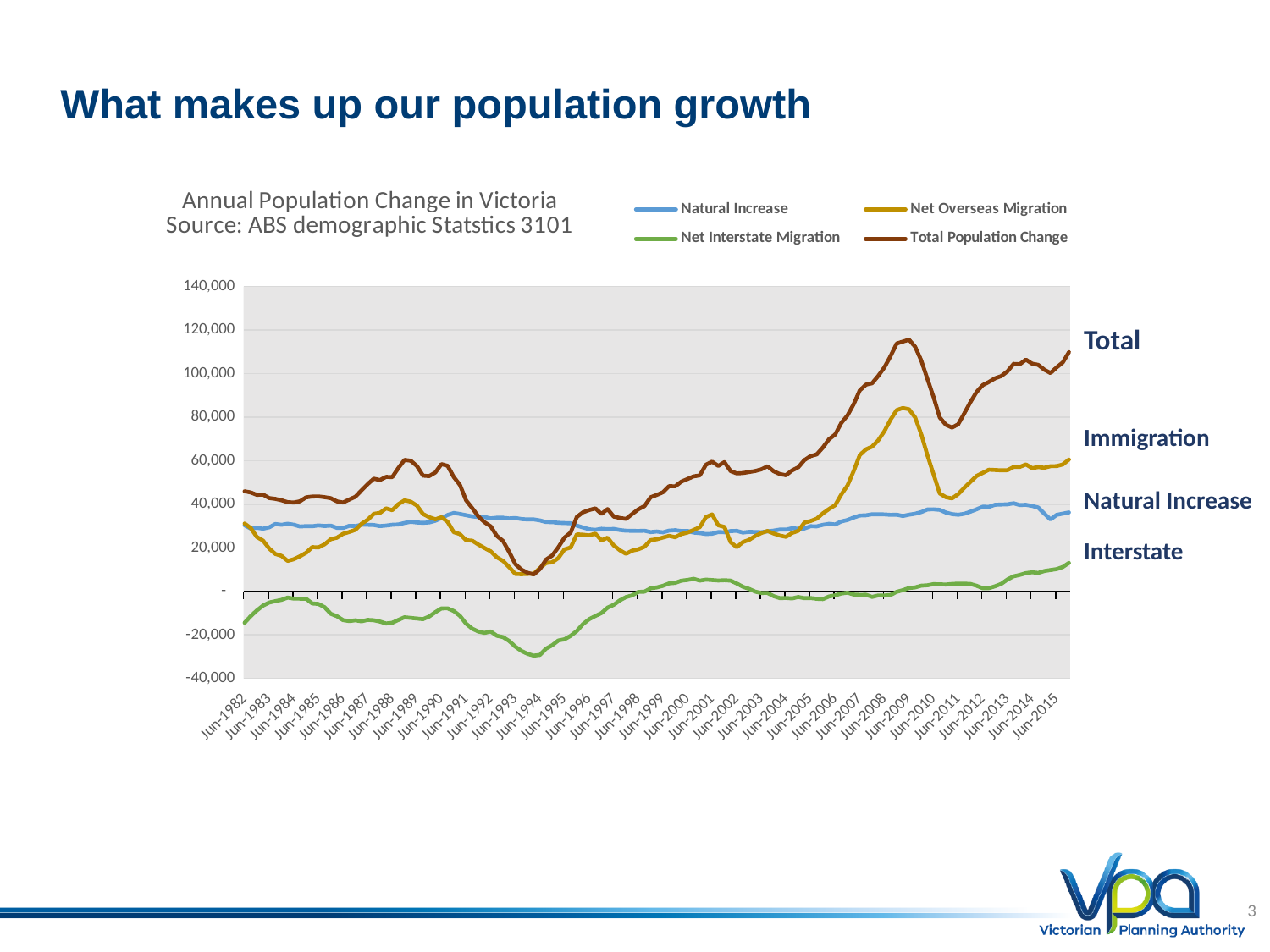
What is the title of the chart? Annual Population Change in Victoria Which series reaches the lowest value on the chart? Net Interstate Migration What kind of chart is shown on the slide? Line chart Is the value for Net Overseas Migration at Jun-2009 greater or less than 60,000? greater How many series does the chart legend list? 4 Is the value for Total Population Change at its Jun-2009 peak greater or less than 100,000? greater Does Total Population Change rise or fall between Jun-2009 and Jun-2011? Fall What source is cited in the chart title? ABS demographic Statstics 3101 Which series reaches the highest value on the chart? Total Population Change At Jun-2015, which is larger: Net Overseas Migration or Natural Increase? Net Overseas Migration Is the value for Net Interstate Migration at Jun-1994 greater or less than -20,000? less At Jun-1984, which is larger: Natural Increase or Net Overseas Migration? Natural Increase